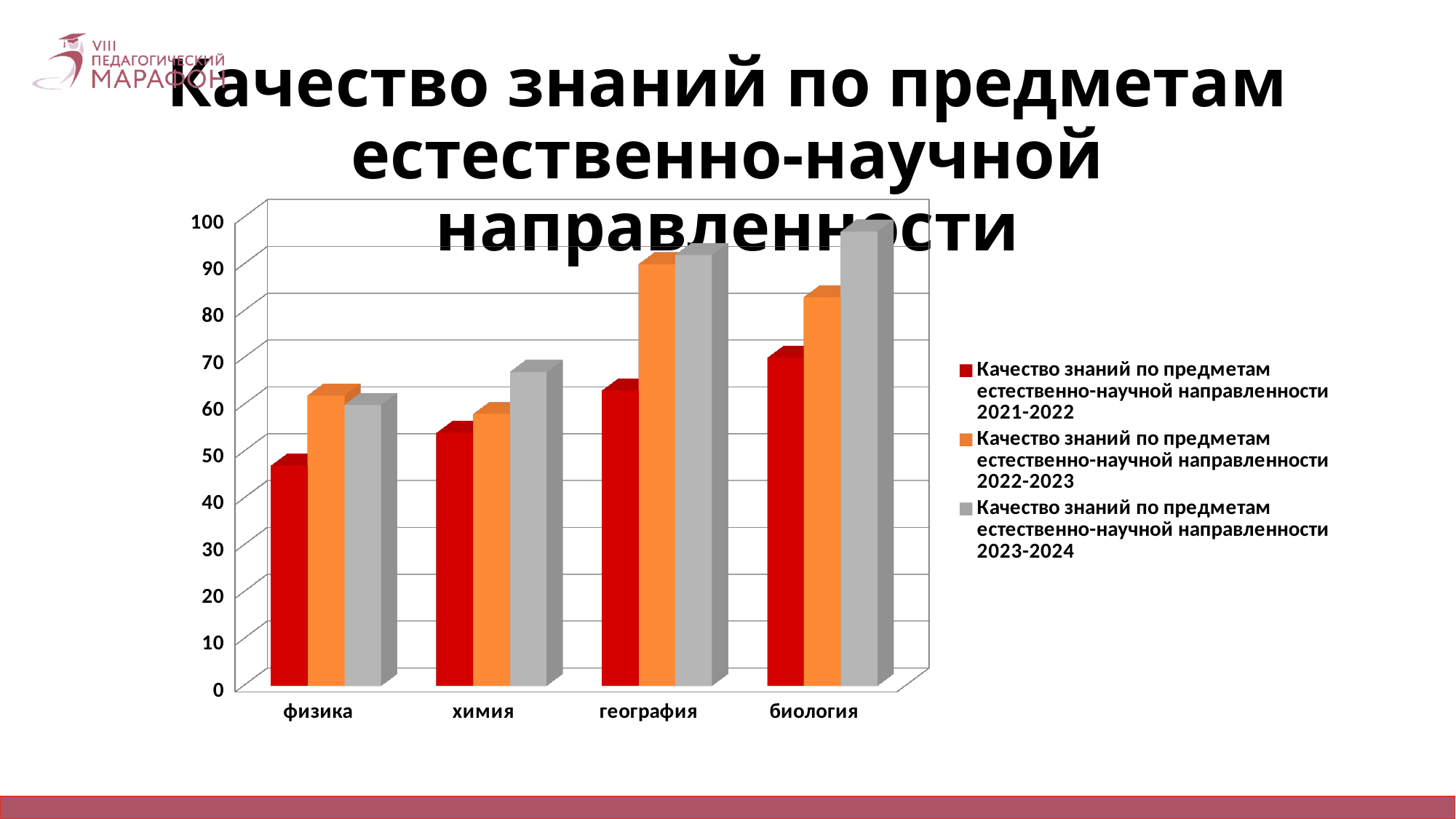
How many subject categories are shown on the x axis? 4 How many series does the legend list? 3 Is the value for физика in 2021-2022 greater or less than 60? less Is the value for химия in 2023-2024 greater or less than 60? greater Is the value for география in 2022-2023 greater or less than 80? greater Which subject has the highest value for 2023-2024? биология Do the 2021-2022 values rise or fall from физика to биология along the x axis? rise Which is larger for 2022-2023: география or физика? география What colour represents the 2023-2024 series in the legend? gray Which subject has the lowest value for 2021-2022? физика What kind of chart is shown on the slide? bar chart